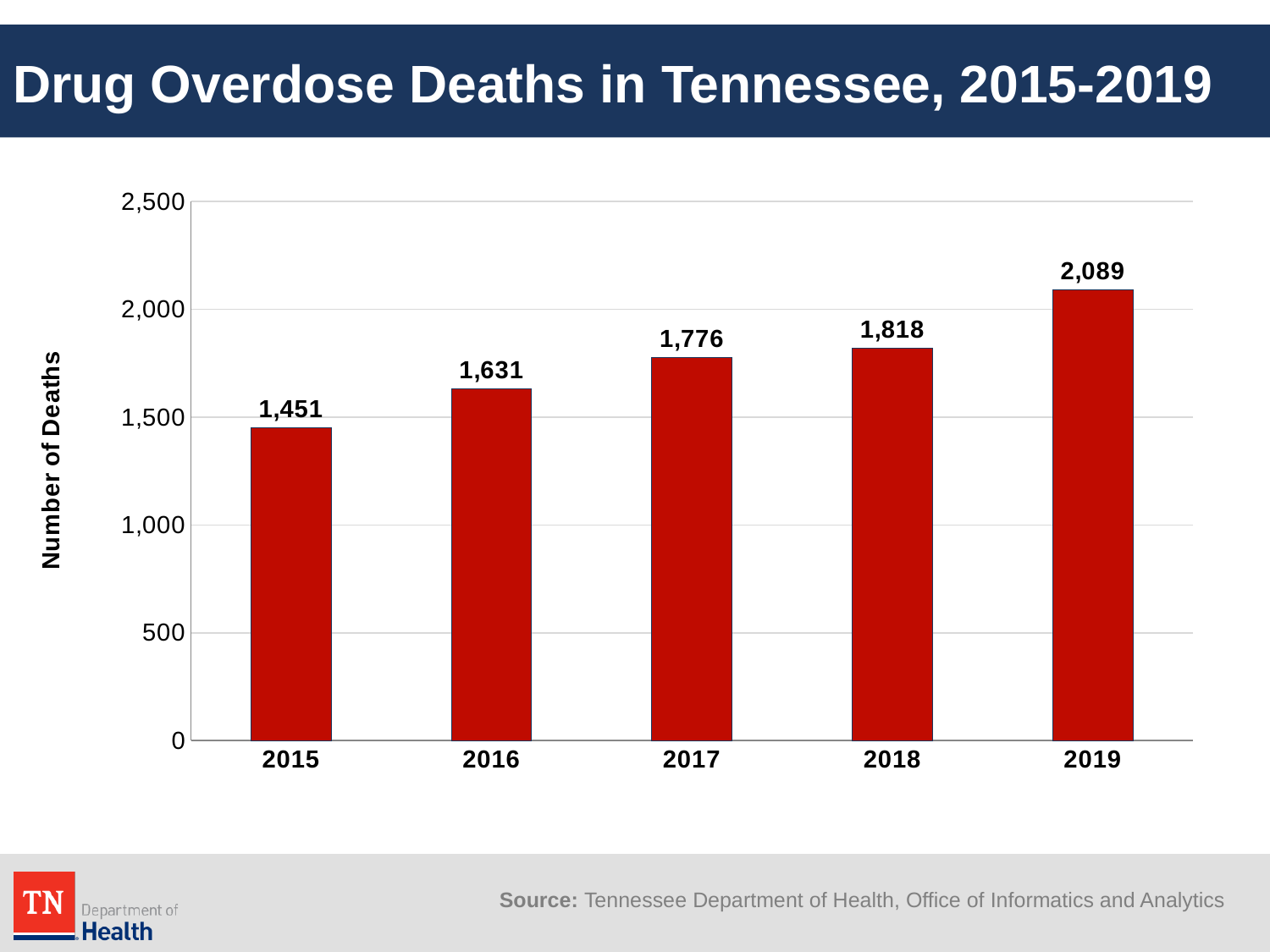
What is the number of deaths shown for 2017? 1,776 How many drug overdose deaths were there in Tennessee in 2015? 1,451 Which year has the lowest number of drug overdose deaths? 2015 How many years are shown on the x axis? 5 Which year had more deaths, 2017 or 2018? 2018 What is the difference in deaths between 2019 and 2018? 271 What is the number of deaths shown for 2019? 2,089 Do the number of deaths rise or fall from 2015 to 2019? Rise How many more deaths were there in 2016 than in 2015? 180 Is the value for 2019 greater or less than 2,000? greater Which year has the highest number of drug overdose deaths? 2019 What kind of chart is shown on the slide? Bar chart